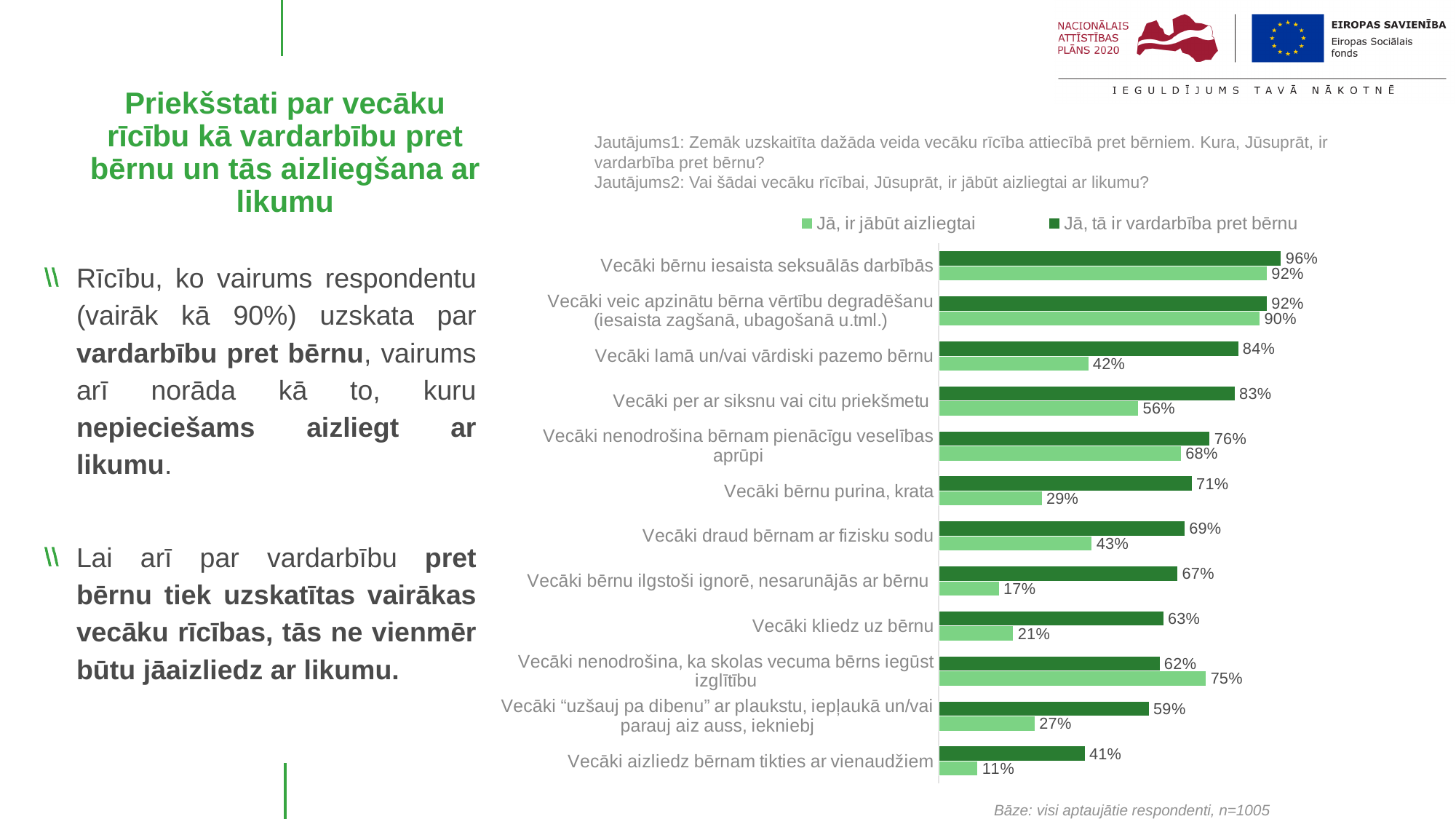
Which legend entry is shown in dark green? Jā, tā ir vardarbība pret bērnu What type of chart is shown on the slide? Bar chart What is the 'Jā, ir jābūt aizliegtai' value for 'Vecāki kliedz uz bērnu'? 21% How many series does the chart legend list? 2 For 'Vecāki nenodrošina, ka skolas vecuma bērns iegūst izglītību', which is larger: the 'Jā, ir jābūt aizliegtai' value or the 'Jā, tā ir vardarbība pret bērnu' value? Jā, ir jābūt aizliegtai What is the 'Jā, ir jābūt aizliegtai' value for 'Vecāki nenodrošina, ka skolas vecuma bērns iegūst izglītību'? 75% Which category has the lowest 'Jā, tā ir vardarbība pret bērnu' value? Vecāki aizliedz bērnam tikties ar vienaudžiem What is the 'Jā, tā ir vardarbība pret bērnu' value for 'Vecāki per ar siksnu vai citu priekšmetu'? 83% What percentage of respondents consider 'Vecāki bērnu iesaista seksuālās darbībās' to be violence against a child (Jā, tā ir vardarbība pret bērnu)? 96% How many categories (types of parental behaviour) are shown in the chart? 12 Which category has the highest 'Jā, ir jābūt aizliegtai' value? Vecāki bērnu iesaista seksuālās darbībās What is the difference between the 'Jā, tā ir vardarbība pret bērnu' and 'Jā, ir jābūt aizliegtai' values for 'Vecāki bērnu ilgstoši ignorē, nesarunājās ar bērnu'? 50 percentage points